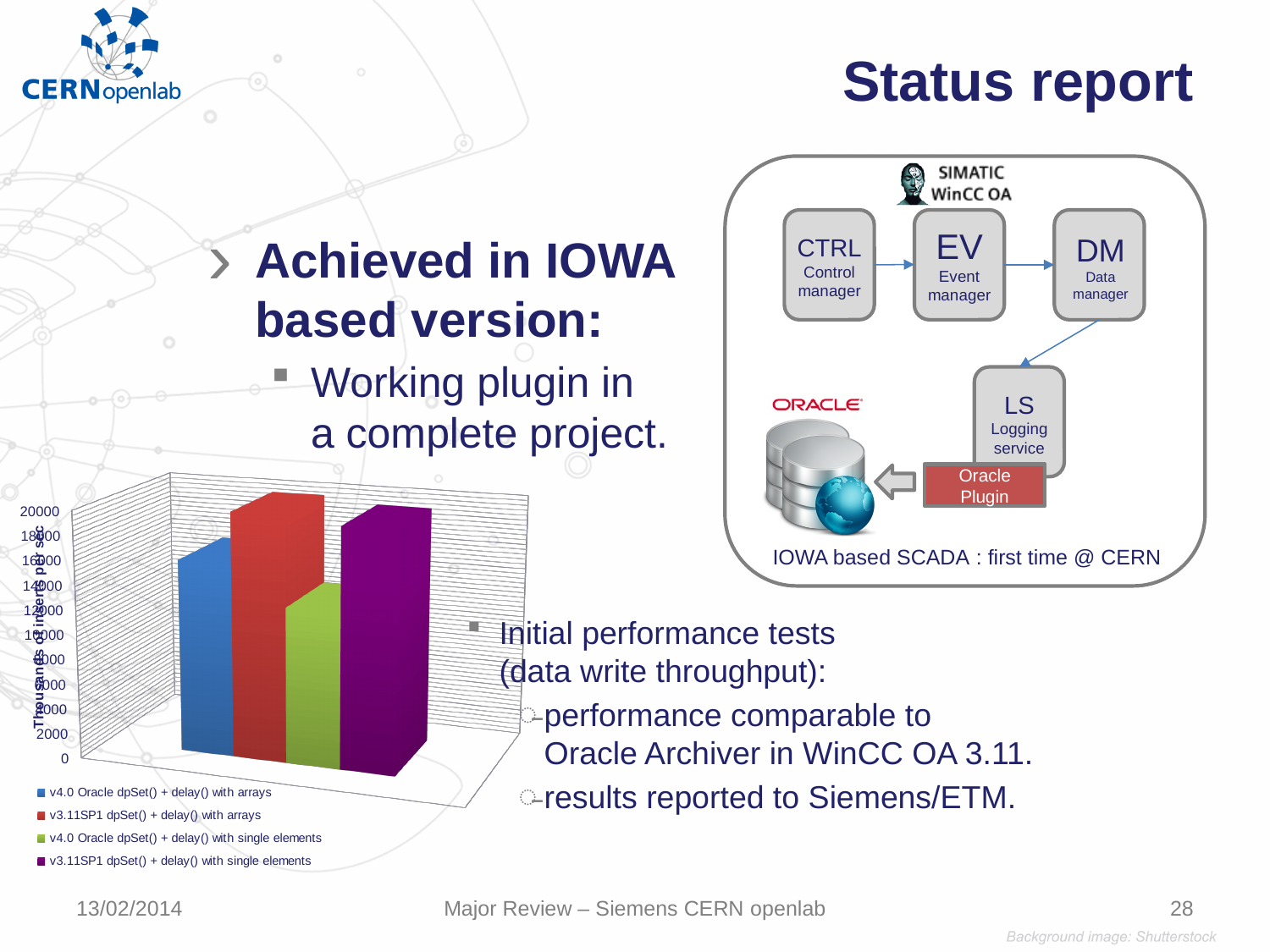
Which is larger: the bar for v3.11SP1 dpSet() + delay() with arrays or the bar for v4.0 Oracle dpSet() + delay() with single elements? v3.11SP1 dpSet() + delay() with arrays How many series does the chart's legend list? 4 Is the value for v3.11SP1 dpSet() + delay() with single elements greater or less than 12000? greater Is the value for v4.0 Oracle dpSet() + delay() with arrays greater or less than 10000? greater Is the value for v3.11SP1 dpSet() + delay() with arrays greater or less than 14000? greater What kind of chart is shown on the slide? bar chart Which series has the highest bar in the chart? v3.11SP1 dpSet() + delay() with arrays How many bars are plotted in the chart? 4 Which series has the lowest bar in the chart? v4.0 Oracle dpSet() + delay() with single elements Which is larger: the bar for v4.0 Oracle dpSet() + delay() with arrays or the bar for v4.0 Oracle dpSet() + delay() with single elements? v4.0 Oracle dpSet() + delay() with arrays What colour is the bar for v3.11SP1 dpSet() + delay() with single elements in the chart? purple